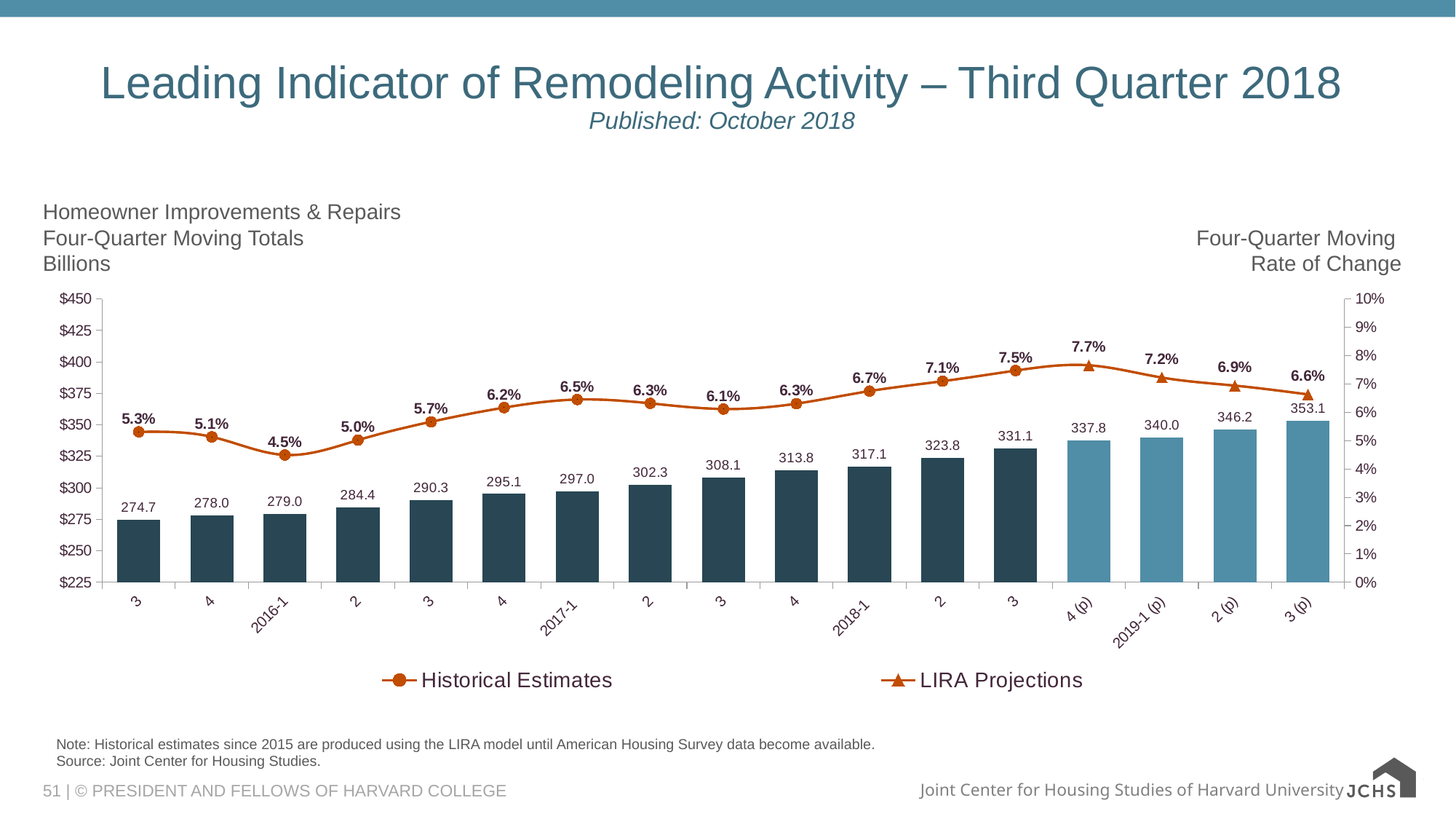
Which has a higher rate of change, 2017-1 or 2018-1? 2018-1 Which category has the lowest four-quarter moving rate of change? 2016-1 What is the four-quarter moving total (in billions) for 2018-1? 317.1 Do the four-quarter moving totals rise or fall from left to right along the x axis? rise How many quarters are shown on the x axis? 17 How many series does the legend list? 2 Is the four-quarter moving total for 2016-1 greater or less than $300? less What is the four-quarter moving rate of change for 2019-1 (p)? 7.2% What are the two series named in the legend? Historical Estimates and LIRA Projections What is the difference in four-quarter moving totals between 3 (p) and 2019-1 (p)? 13.1 What is the four-quarter moving total (in billions) for 3 (p)? 353.1 Which category has the highest four-quarter moving rate of change? 4 (p)